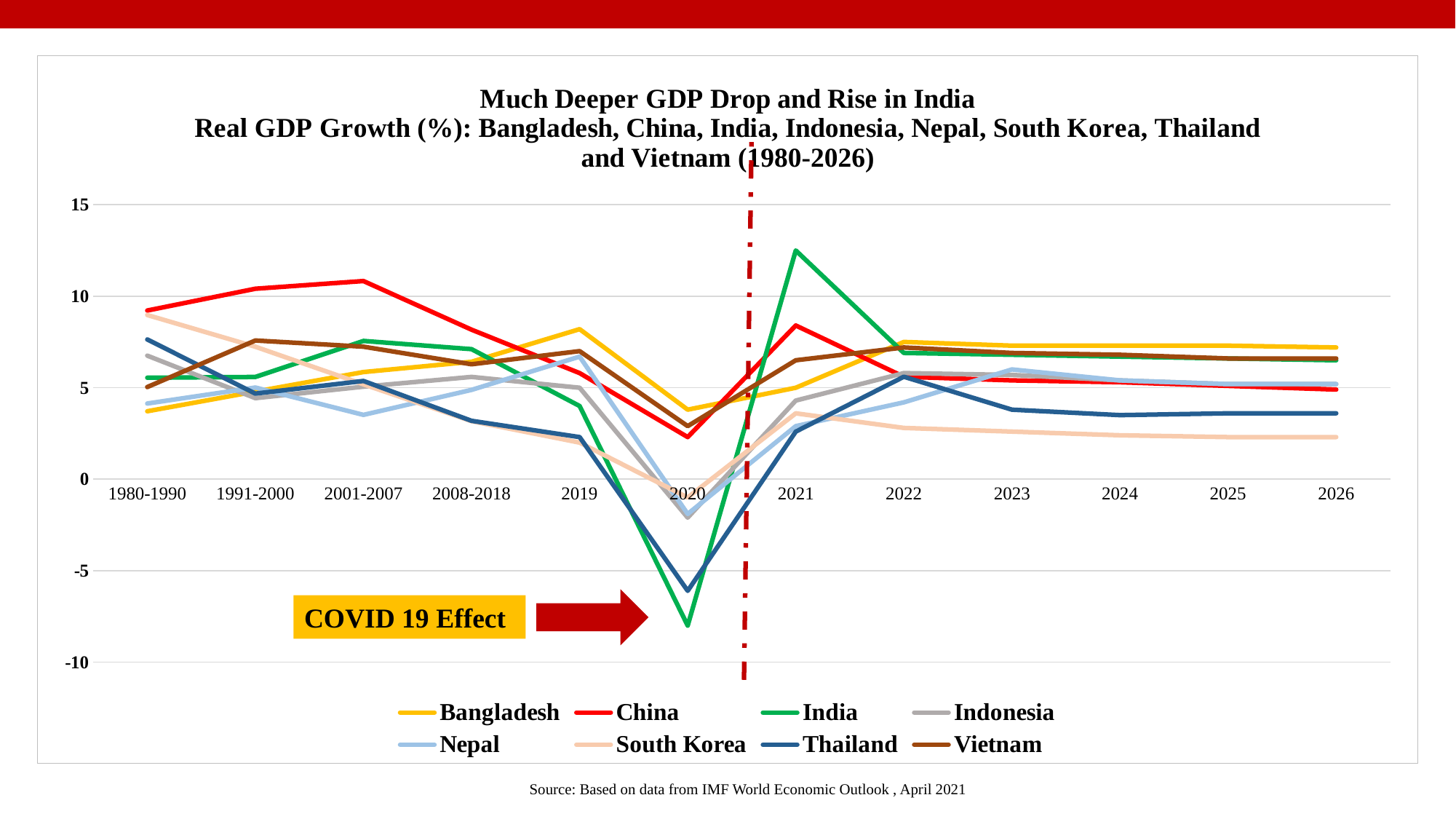
Is the value for India in 2021 greater or less than 10? greater Which country has the highest real GDP growth in 2021? India Which country has the lowest real GDP growth in 2020? India Which is larger in 2026, the value for Vietnam or the value for South Korea? Vietnam What kind of chart is shown on the slide? line chart Is the value for India in 2020 greater or less than -5? less Which country has the highest real GDP growth in 2001-2007? China How many series does the legend list? 8 How many periods are shown along the x axis? 12 Does China's real GDP growth rise or fall from 2021 to 2026? fall What colour is the line for India in the legend? green Is the value for Bangladesh in 2019 greater or less than 5? greater